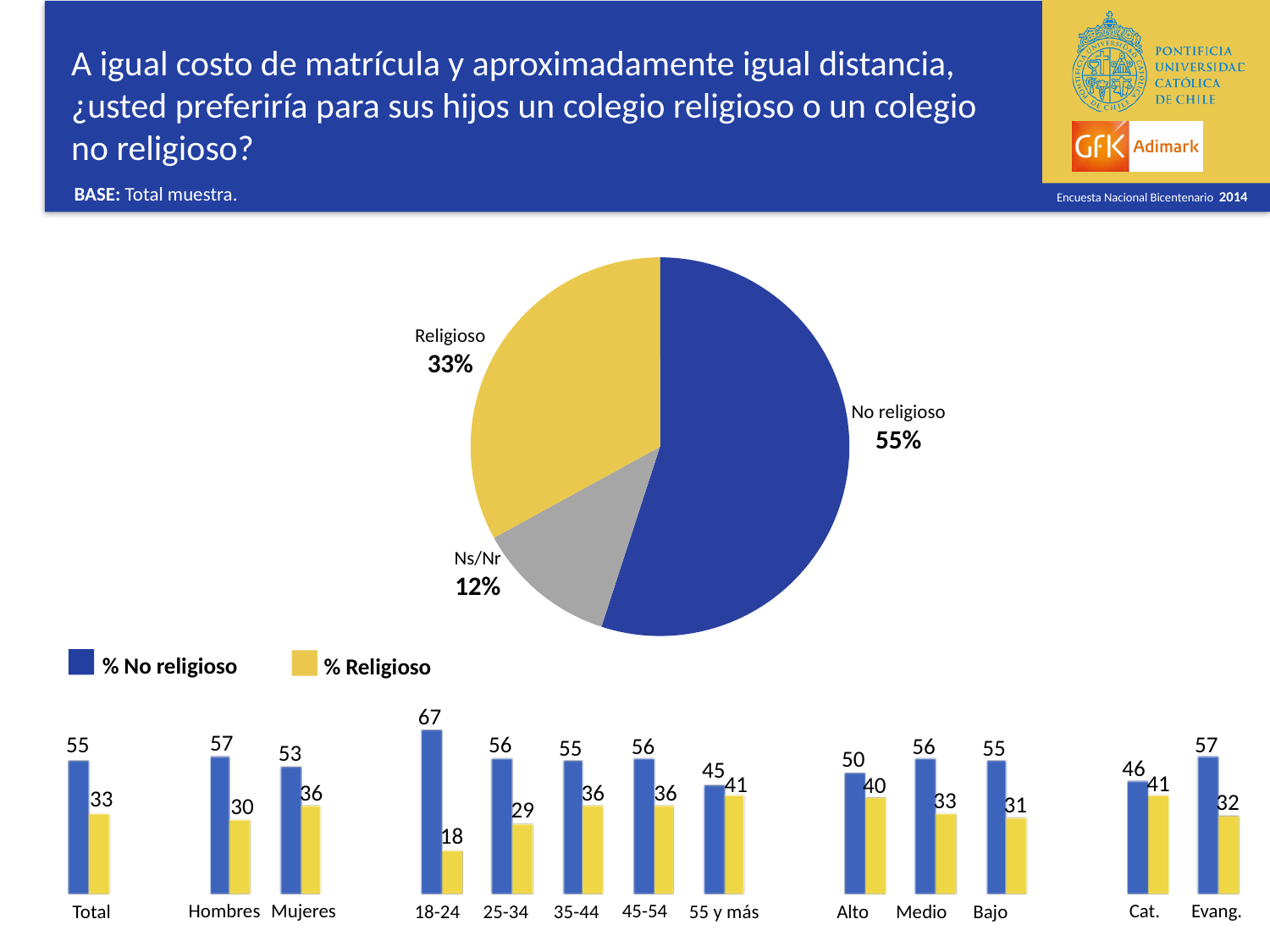
In the pie chart, what share of respondents answered "No religioso"? 55% In the pie chart, which slice is the smallest? Ns/Nr In the bar chart, what is the difference between "% No religioso" and "% Religioso" for the 18-24 group? 49 In the bar chart, what is the "% No religioso" value for the 18-24 group? 67 How many slices does the pie chart have? 3 In the bar chart, which category has the highest "% No religioso" value? 18-24 In the bar chart, what is the "% Religioso" value for Hombres? 30 In the bar chart, which category has the lowest "% Religioso" value? 18-24 How many series does the legend of the bar chart list? 2 In the bar chart, which is larger for the Alto group: "% No religioso" or "% Religioso"? % No religioso What type of chart is shown at the bottom of the slide? Bar chart In the pie chart, what percentage is shown for "Ns/Nr"? 12%